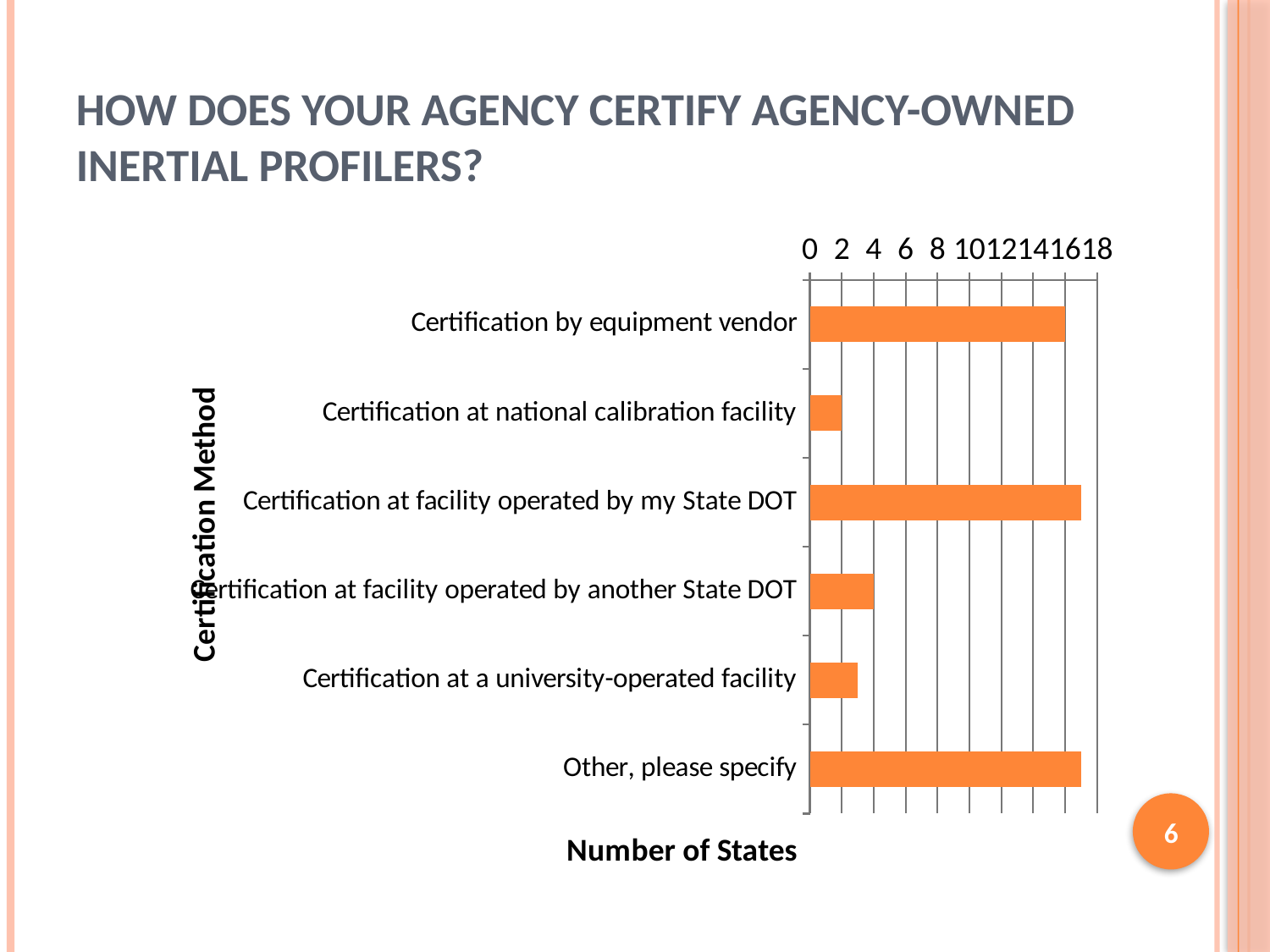
Is the value for Other, please specify greater or less than 10? greater How many certification methods are shown on the chart? 6 What is the title of the vertical axis? Certification Method Which is larger, the value for Certification by equipment vendor or the value for Certification at facility operated by another State DOT? Certification by equipment vendor Is the value for Certification at facility operated by my State DOT greater or less than 16? greater What kind of chart is shown on the slide? bar chart What is the difference between the value for Certification by equipment vendor and the value for Certification at facility operated by another State DOT? 12 What is the value for Certification by equipment vendor? 16 What is the value for Certification at national calibration facility? 2 What is the title of the horizontal axis? Number of States Is the value for Certification at a university-operated facility greater or less than 4? less What is the value for Certification at facility operated by another State DOT? 4